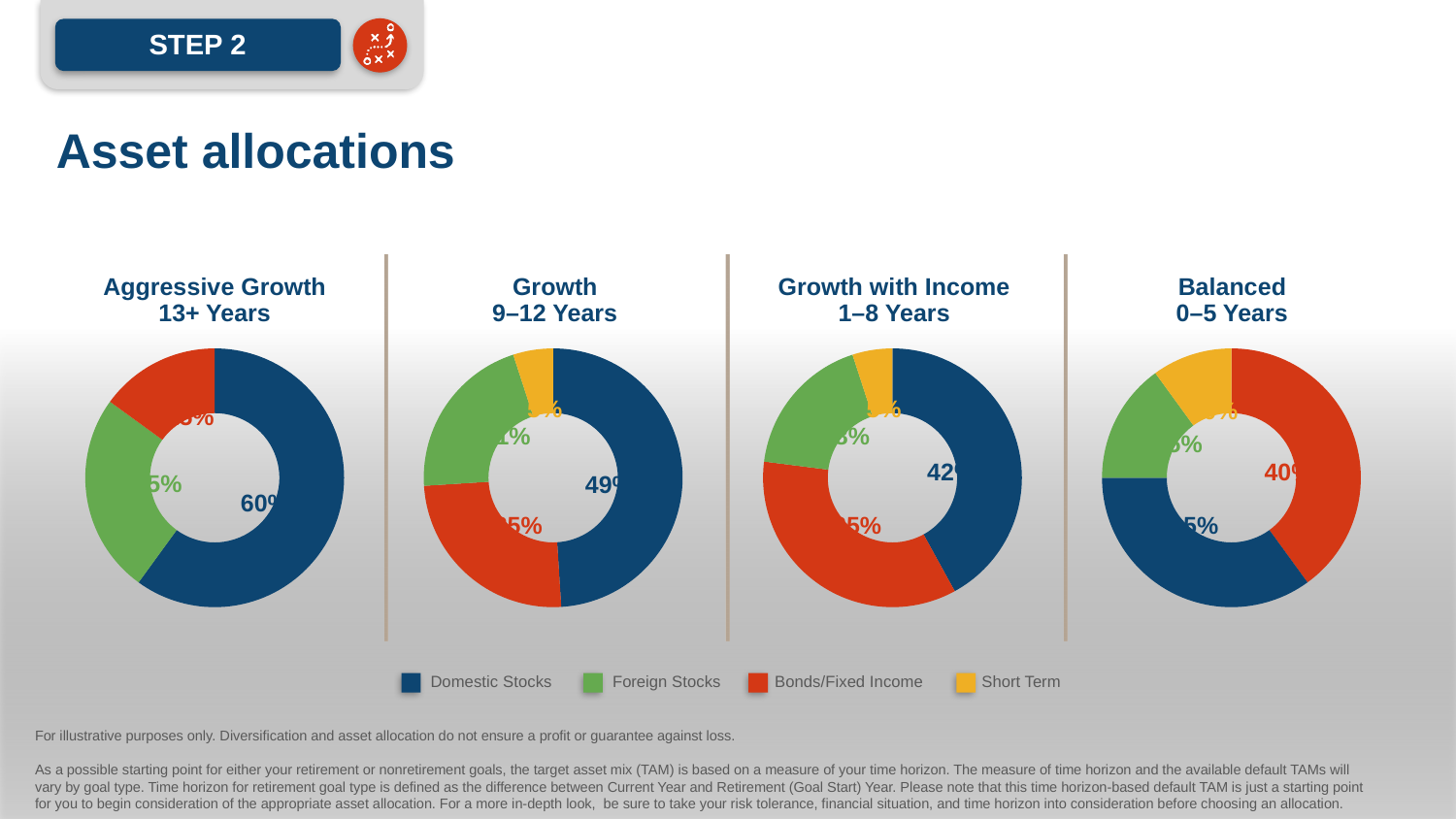
In the Growth 9–12 Years chart, what share is Domestic Stocks? 49% How many asset classes does the legend list? 4 In the Growth with Income 1–8 Years chart, which is larger: Domestic Stocks or Foreign Stocks? Domestic Stocks In the Balanced 0–5 Years chart, which asset class has the largest share? Bonds/Fixed Income In the Aggressive Growth 13+ Years chart, which asset class has the largest share? Domestic Stocks How many allocation charts are shown on the slide? 4 What time horizon is shown under the Growth chart title? 9–12 Years What kind of chart is used for the Aggressive Growth 13+ Years allocation? doughnut chart Which allocation chart has no Short Term slice? Aggressive Growth 13+ Years In the Growth 9–12 Years chart, which asset class has the smallest share? Short Term In the Aggressive Growth 13+ Years chart, what share is Domestic Stocks? 60% In the Aggressive Growth 13+ Years chart, which asset class has the smallest share? Bonds/Fixed Income